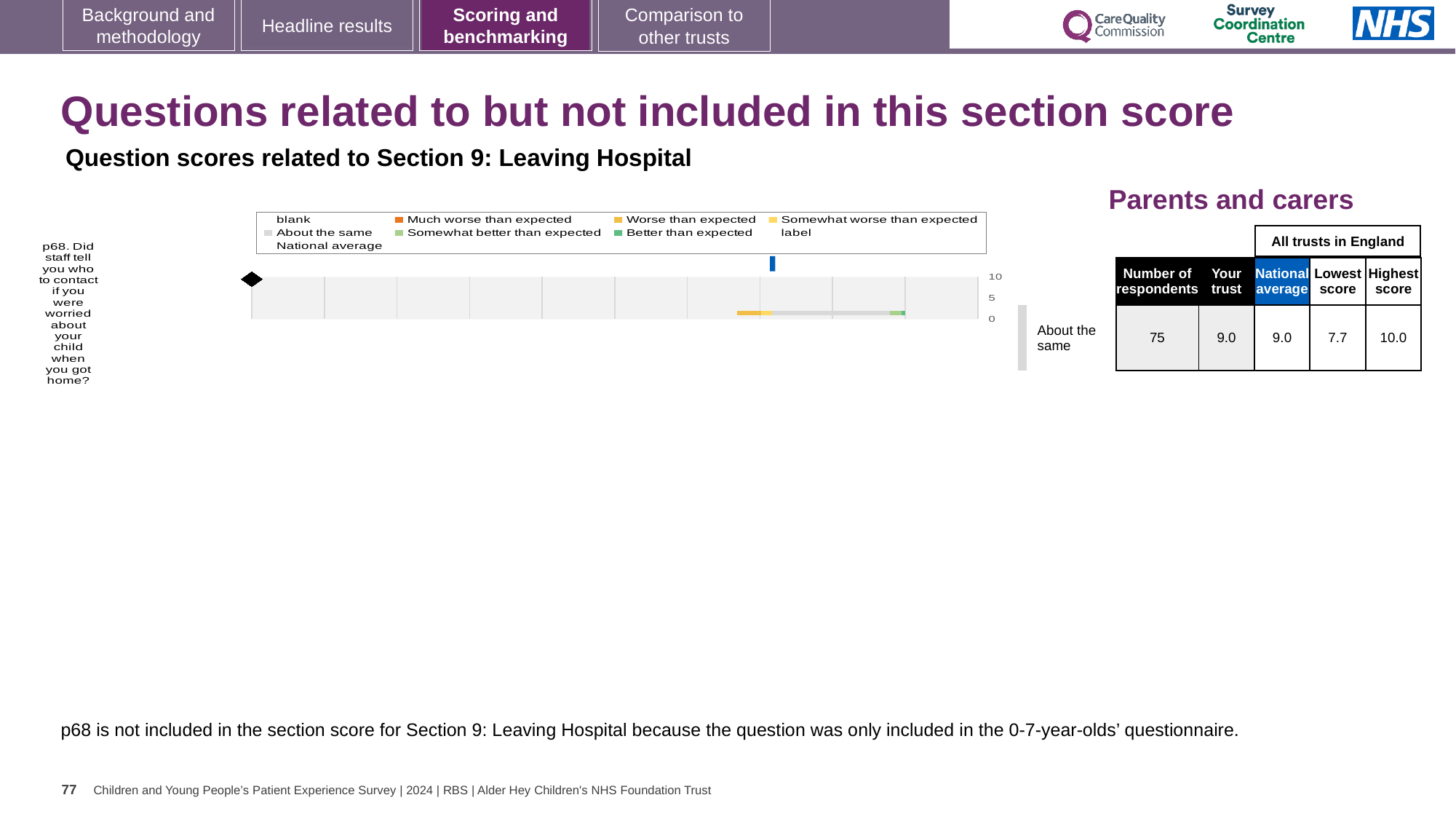
Which group of respondents does the chart relate to, according to the heading above the table? Parents and carers How many questions are plotted in the chart? 1 Is the 'Your trust' score for p68 higher than, lower than, or the same as the national average? the same What is the highest score among all trusts in England for p68? 10.0 What is the lowest score among all trusts in England for p68? 7.7 What is the difference between the highest score and the lowest score for p68? 2.3 What kind of chart is used to show the p68 question score? bar chart What is the national average score for p68? 9.0 What is the 'Your trust' score for p68? 9.0 Which question number is plotted in the chart? p68 What rating category is shown for p68 next to the chart? About the same What is the number of respondents for p68? 75